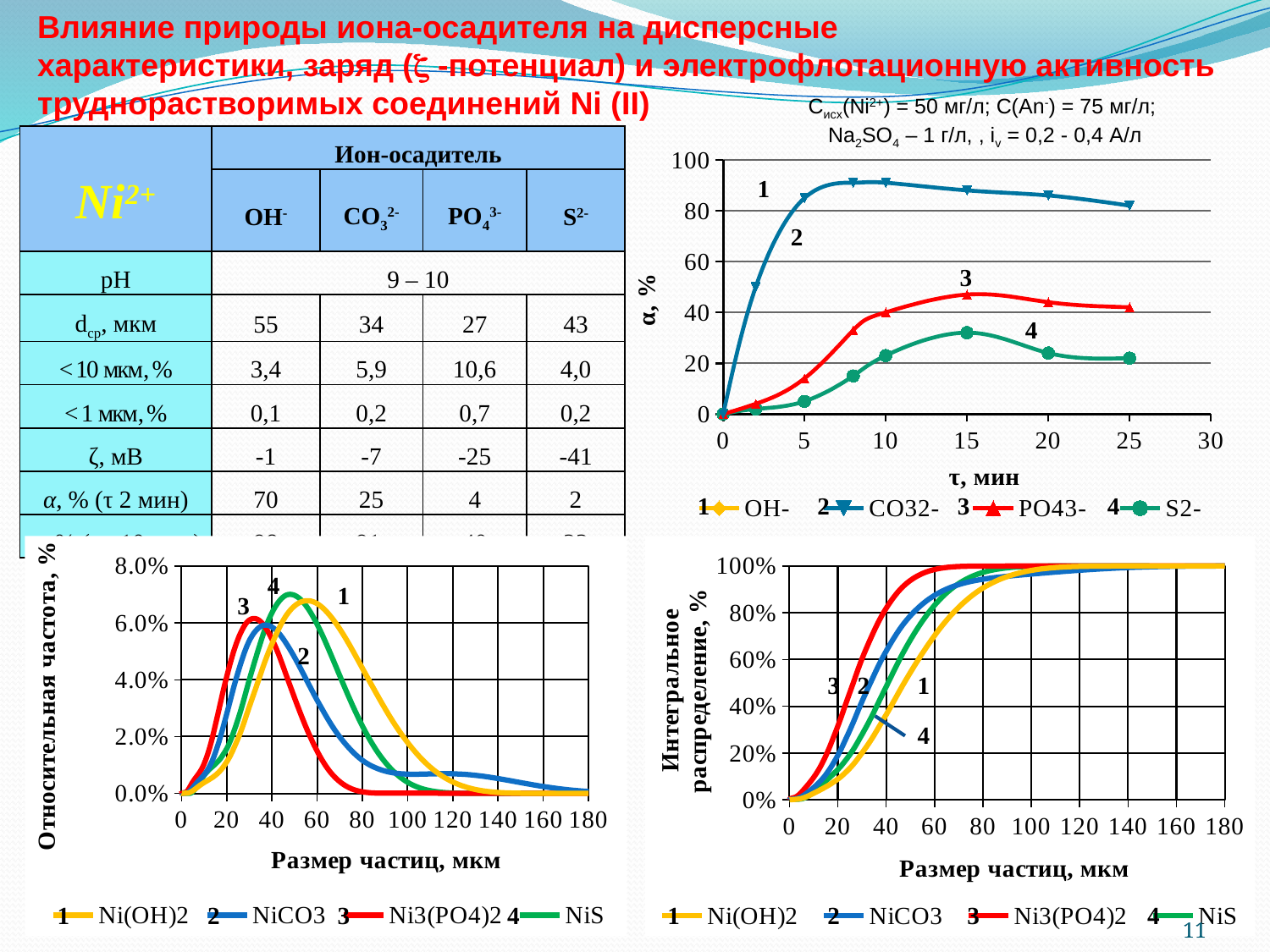
In the bottom-left chart, how many series does the legend list? 4 What is the y-axis title of the bottom-left chart? Относительная частота, % In the top-right chart, at τ = 20 мин, which is larger: the value for CO32- or the value for PO43-? CO32- In the top-right chart, is the value for S2- at τ = 15 мин greater or less than 40? less In the top-right chart (α, % vs τ, мин), how many series does the legend list? 4 In the top-right chart, is the value for CO32- at τ = 10 мин greater or less than 80? greater What is the x-axis title of the top-right chart? τ, мин In the top-right chart, is the value for PO43- at τ = 15 мин greater or less than 40? greater What kind of chart is the top-right chart showing α, % against τ, мин? line chart